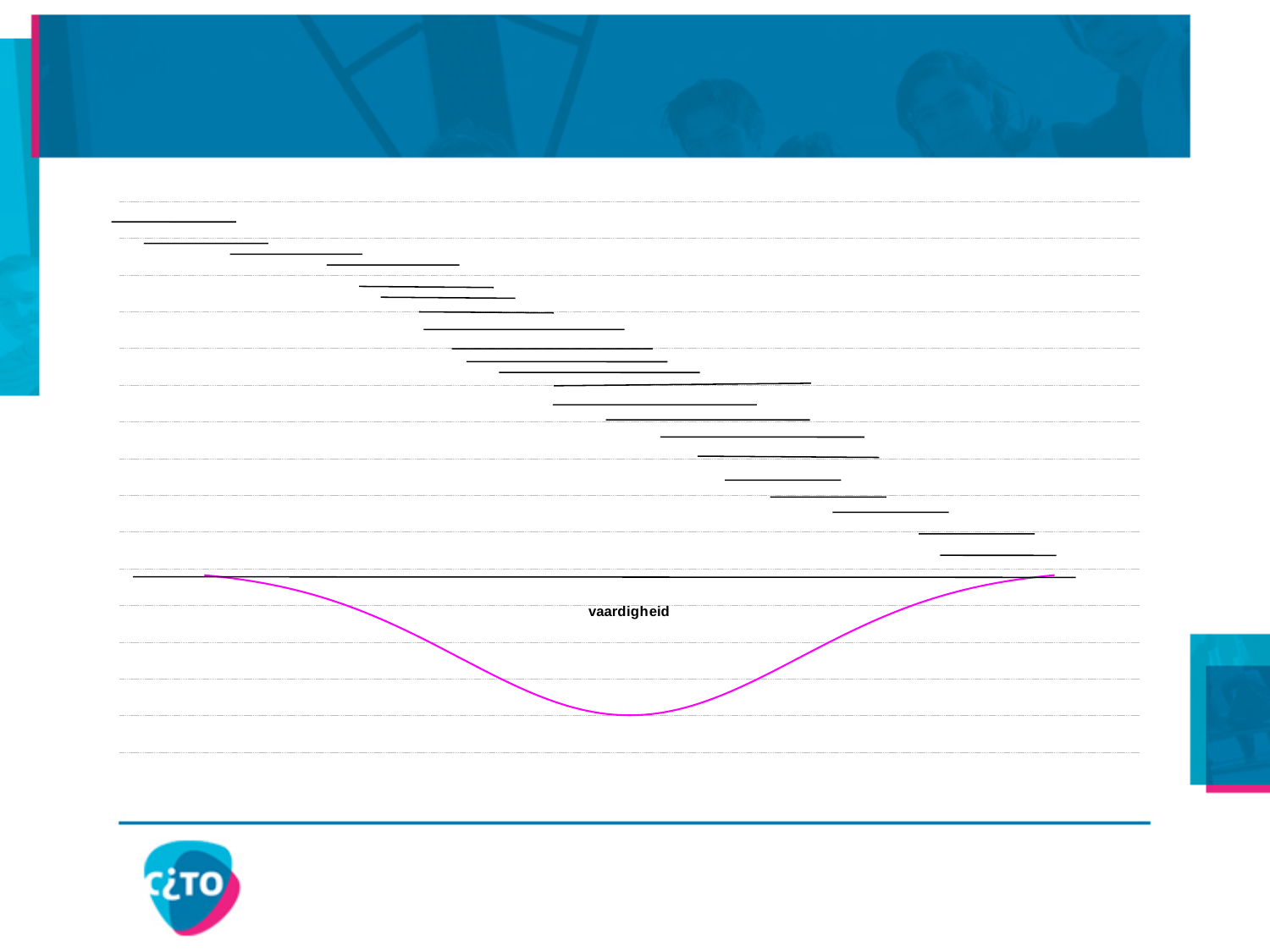
Moving from left to right, do the short horizontal segments step downward or upward? downward Is the magenta curve at its lowest point in the middle of the chart or at its ends? in the middle What text label is printed beneath the long horizontal line in the chart? vaardigheid What colour is the curved line drawn in the lower part of the chart? magenta Does the magenta curve rise or fall from its midpoint toward the right edge? rise